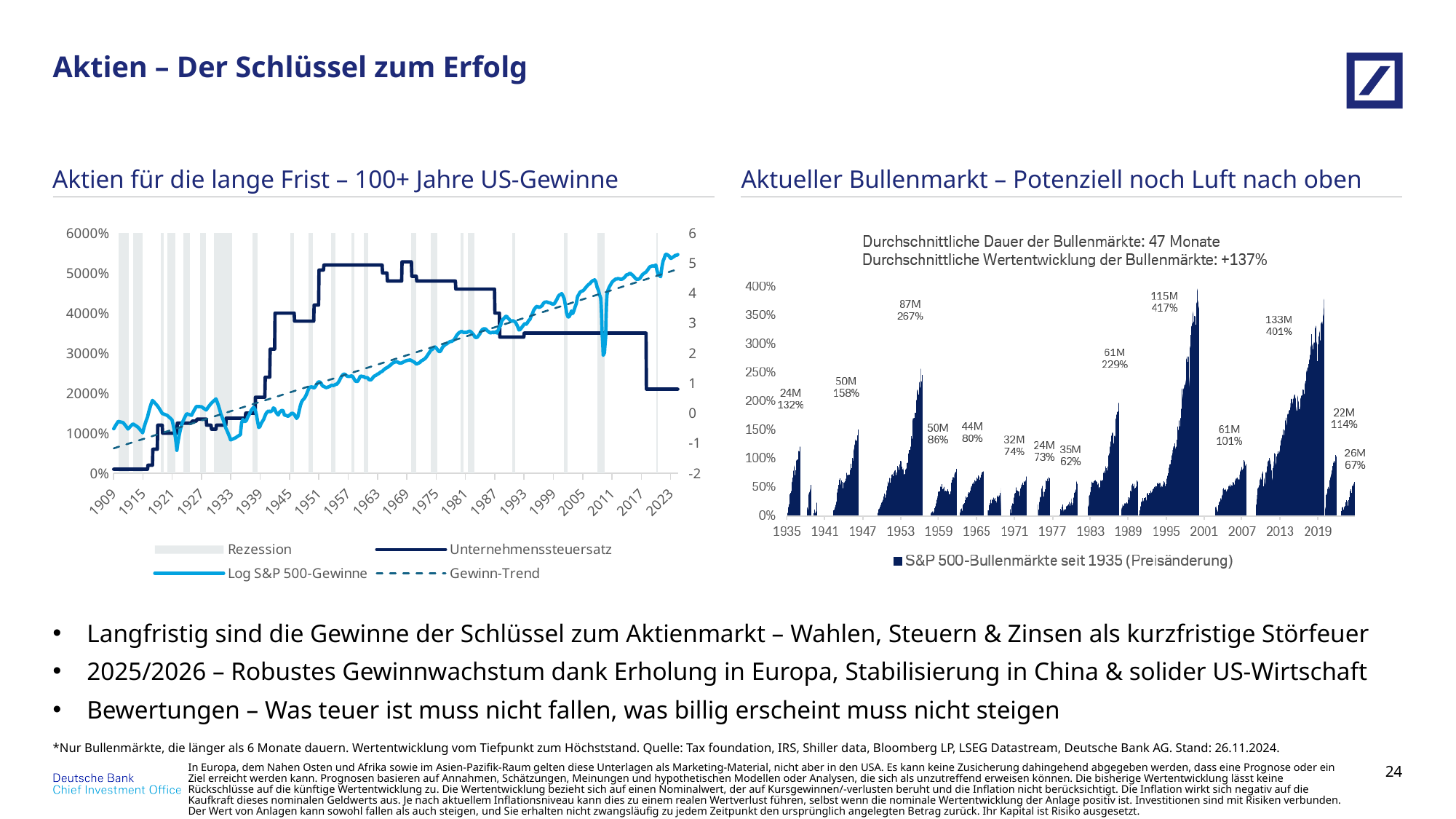
In the chart 'Aktueller Bullenmarkt – Potenziell noch Luft nach oben', what is the legend entry for the plotted series? S&P 500-Bullenmärkte seit 1935 (Preisänderung) In the chart 'Aktueller Bullenmarkt – Potenziell noch Luft nach oben', which has the higher performance: the 87M bull market or the 61M bull market labelled 229%? 87M (267%) In the chart 'Aktueller Bullenmarkt – Potenziell noch Luft nach oben', what is the average performance of bull markets stated in the chart text? +137% In the chart 'Aktueller Bullenmarkt – Potenziell noch Luft nach oben', which labelled bull market has the lowest performance? 35M (62%) In the chart 'Aktueller Bullenmarkt – Potenziell noch Luft nach oben', what is the performance of the most recent bull market labelled 26M? 67% In the chart 'Aktueller Bullenmarkt – Potenziell noch Luft nach oben', what is the average duration of bull markets stated in the chart text? 47 Monate How many series does the legend of the chart 'Aktien für die lange Frist – 100+ Jahre US-Gewinne' list? 4 In the chart 'Aktueller Bullenmarkt – Potenziell noch Luft nach oben', what is the performance of the bull market labelled 133M? 401% In the chart 'Aktueller Bullenmarkt – Potenziell noch Luft nach oben', what is the difference in performance between the 115M bull market (417%) and the 133M bull market (401%)? 16 percentage points In the chart 'Aktien für die lange Frist – 100+ Jahre US-Gewinne', what is the overall trend of the Log S&P 500-Gewinne line from 1909 to 2023? Rising In the chart 'Aktueller Bullenmarkt – Potenziell noch Luft nach oben', what is the performance of the bull market labelled 115M? 417% In the chart 'Aktueller Bullenmarkt – Potenziell noch Luft nach oben', which labelled bull market has the highest performance? 115M (417%)